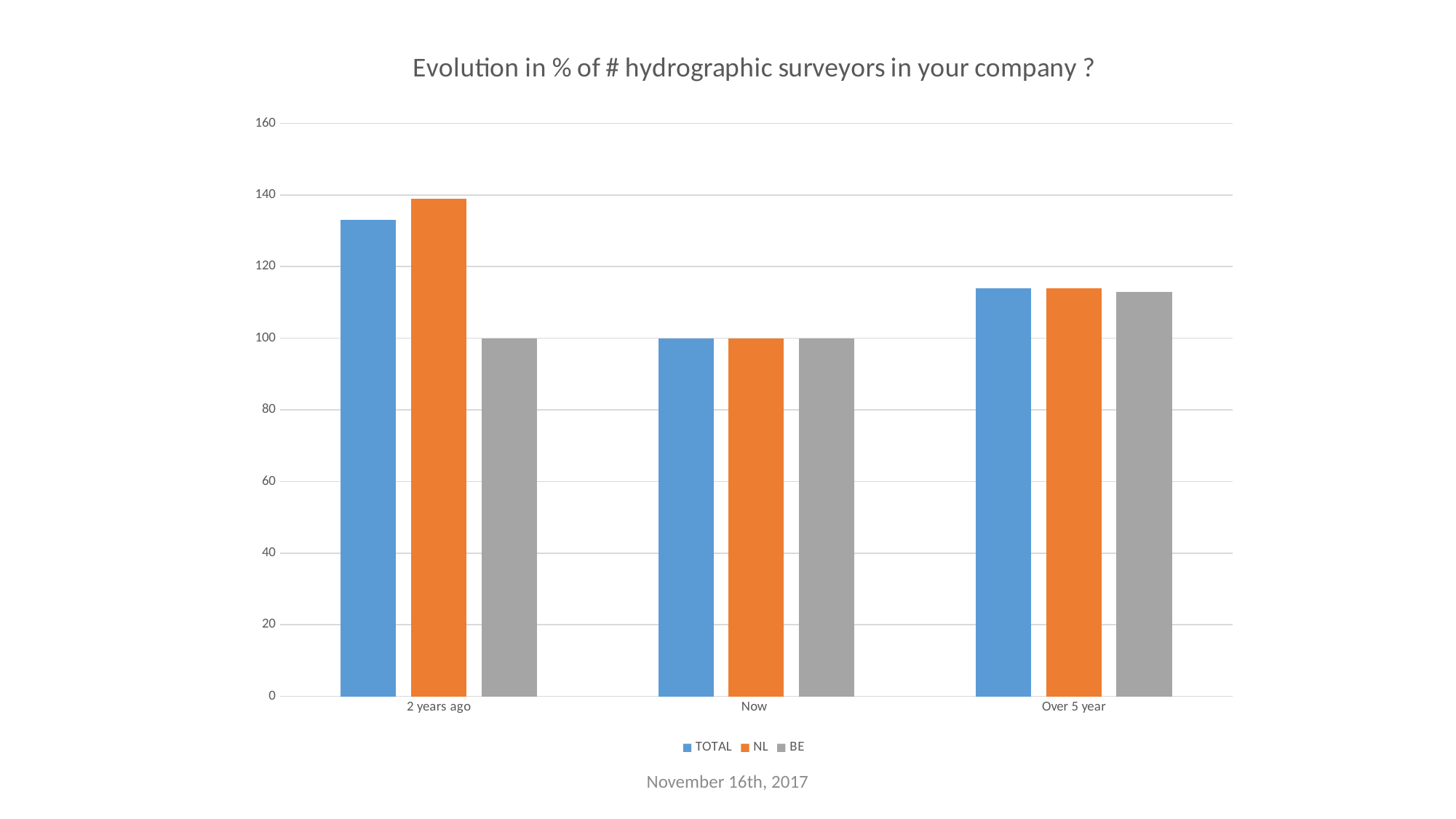
What colour represents the NL series? orange Is the value for NL in 'Over 5 year' greater or less than 120? less What is the value for TOTAL in the 'Now' category? 100 Which series has the highest value in the '2 years ago' category? NL What is the value for BE in the '2 years ago' category? 100 Is the value for TOTAL in '2 years ago' greater or less than 120? greater Does the value for BE rise or fall from 'Now' to 'Over 5 year'? rise How many categories are shown on the x axis? 3 In the '2 years ago' category, which is larger, TOTAL or BE? TOTAL Which series has the lowest value in the '2 years ago' category? BE What kind of chart is shown on the slide? bar chart How many series does the legend list? 3